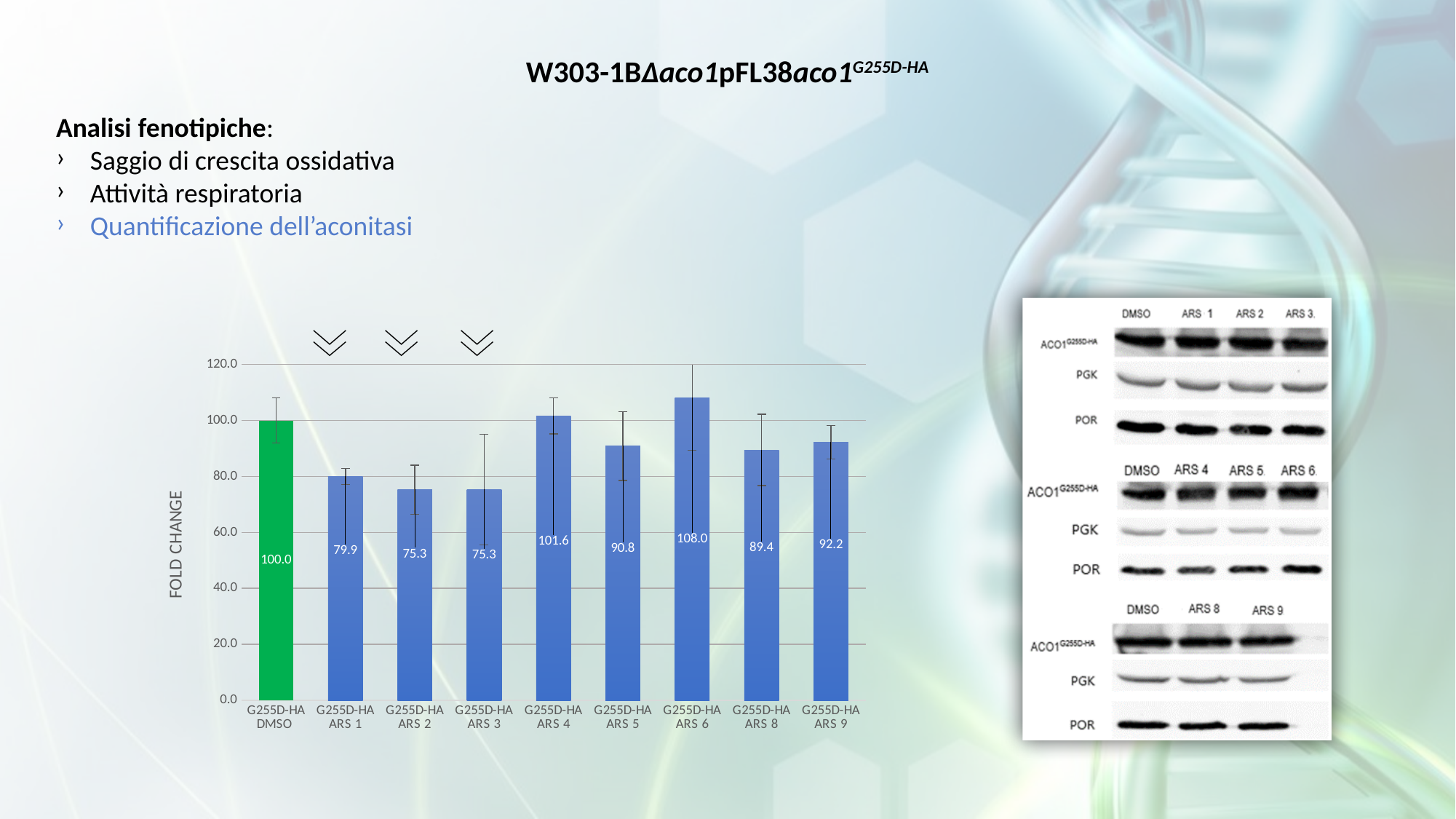
What is the fold change value for G255D-HA ARS 6? 108.0 What is the difference between the fold change for G255D-HA DMSO and G255D-HA ARS 1? 20.1 How many bars are plotted on the chart? 9 Which category has the highest fold change? G255D-HA ARS 6 What is the label of the vertical axis of the chart? FOLD CHANGE What kind of chart is shown on the slide? bar chart What is the lowest fold change value shown on the chart? 75.3 What is the fold change value for G255D-HA ARS 1? 79.9 Is the fold change for G255D-HA ARS 8 greater or less than 100.0? less Which bar on the chart is coloured green rather than blue? G255D-HA DMSO What is the fold change value for G255D-HA DMSO? 100.0 Which has a larger fold change, G255D-HA ARS 4 or G255D-HA ARS 5? G255D-HA ARS 4